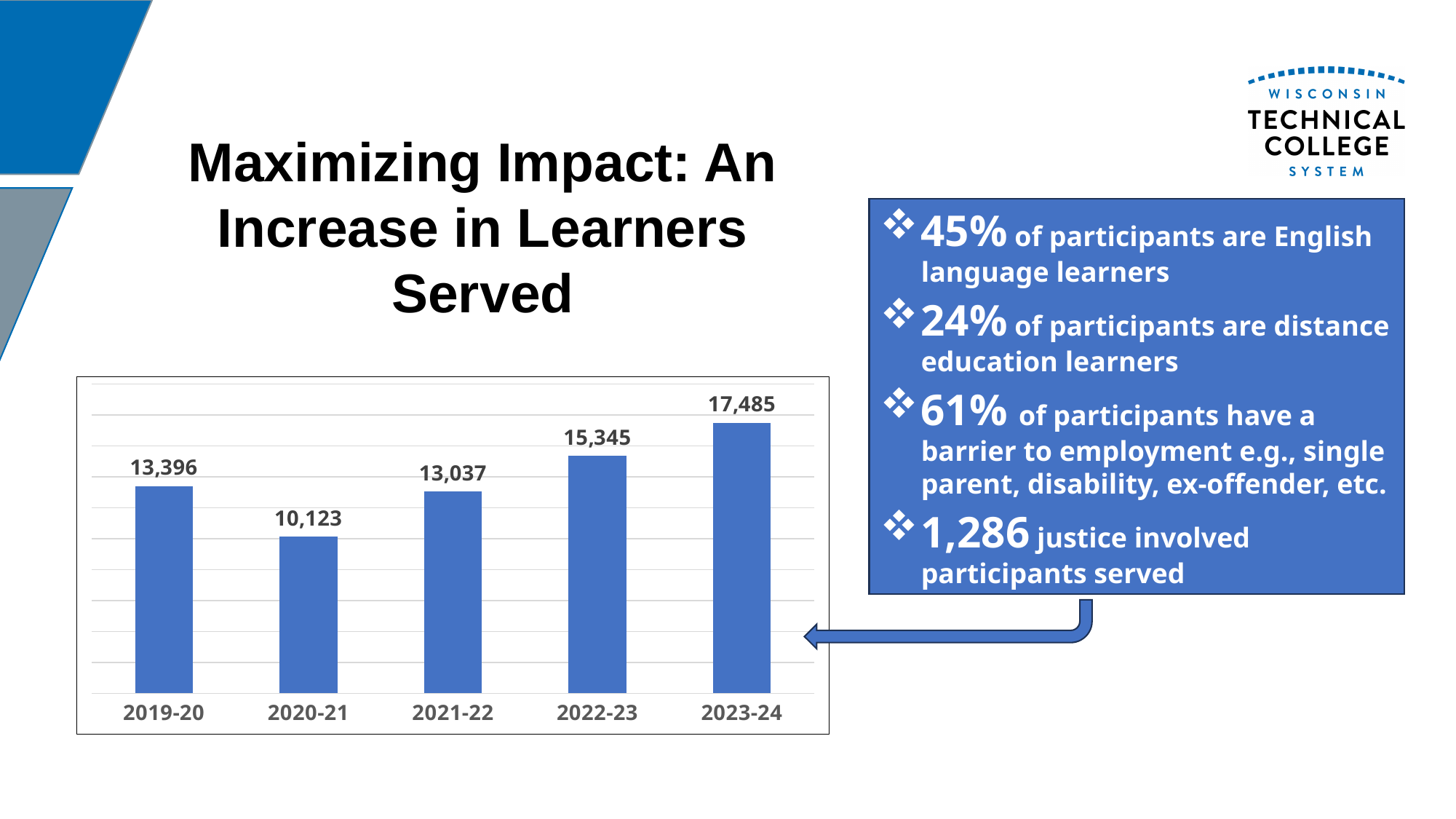
How many years are shown on the chart? 5 What is the value for 2020-21? 10,123 Which year has the highest value? 2023-24 What is the value for 2019-20? 13,396 What is the difference between the values for 2023-24 and 2022-23? 2,140 Which year has the lowest value? 2020-21 What is the difference between the values for 2019-20 and 2020-21? 3,273 Which is larger, the value for 2019-20 or the value for 2021-22? 2019-20 What is the value for 2021-22? 13,037 What is the value for 2022-23? 15,345 What is the value for 2023-24? 17,485 What kind of chart is shown on the slide? Bar chart